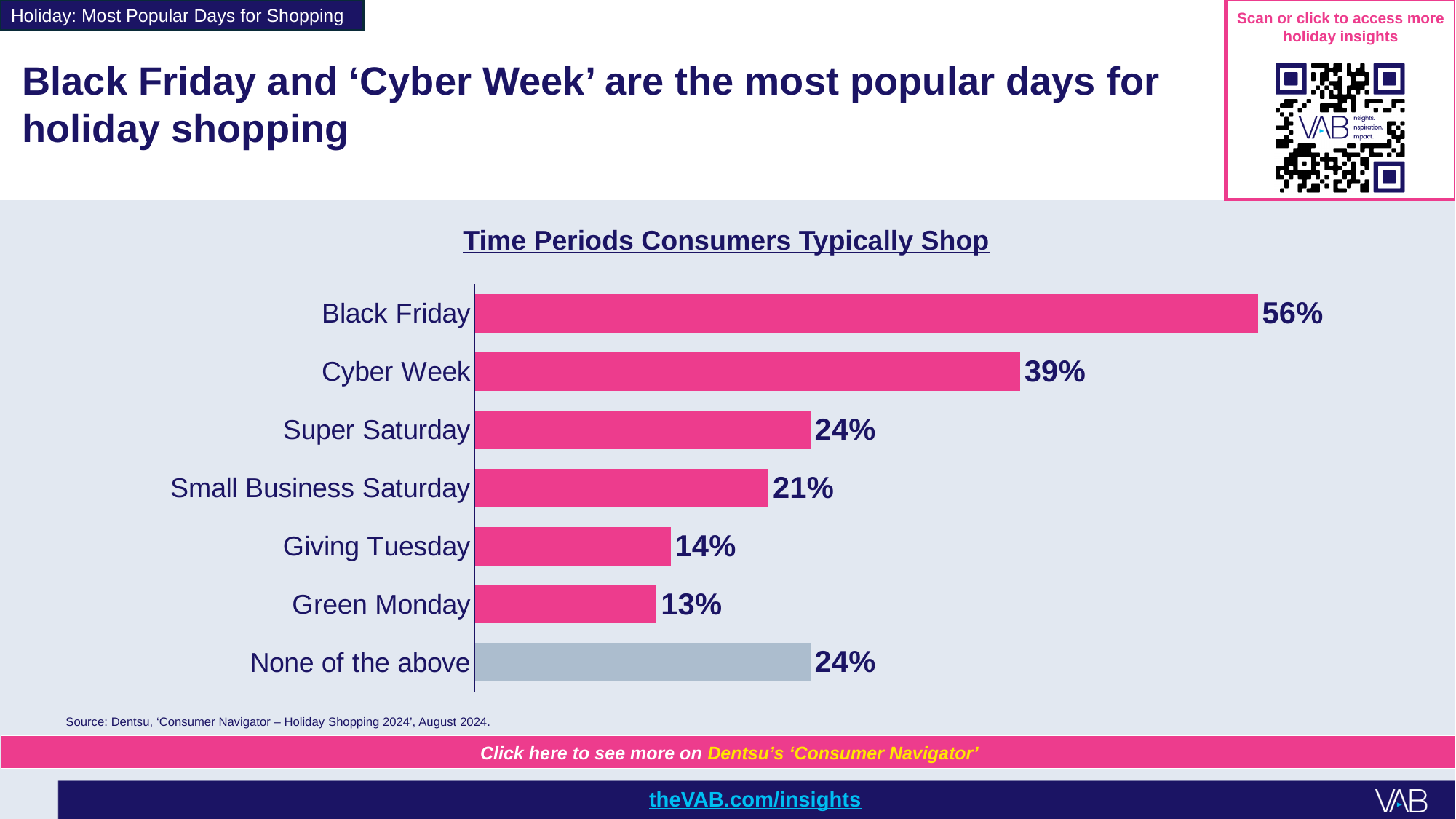
What percentage of consumers typically shop on Black Friday? 56% What is the difference between the values for Black Friday and Cyber Week? 17% Which time period has the highest value in the chart? Black Friday Which time period has the lowest value in the chart? Green Monday How many categories are shown in the chart? 7 What is the difference between the values for Super Saturday and Giving Tuesday? 10% What is the value shown for Small Business Saturday? 21% What is the value shown for Green Monday? 13% What is the title of the chart? Time Periods Consumers Typically Shop What type of chart is shown on the slide? Bar chart Which has a larger value, Giving Tuesday or Green Monday? Giving Tuesday What is the value shown for Cyber Week? 39%